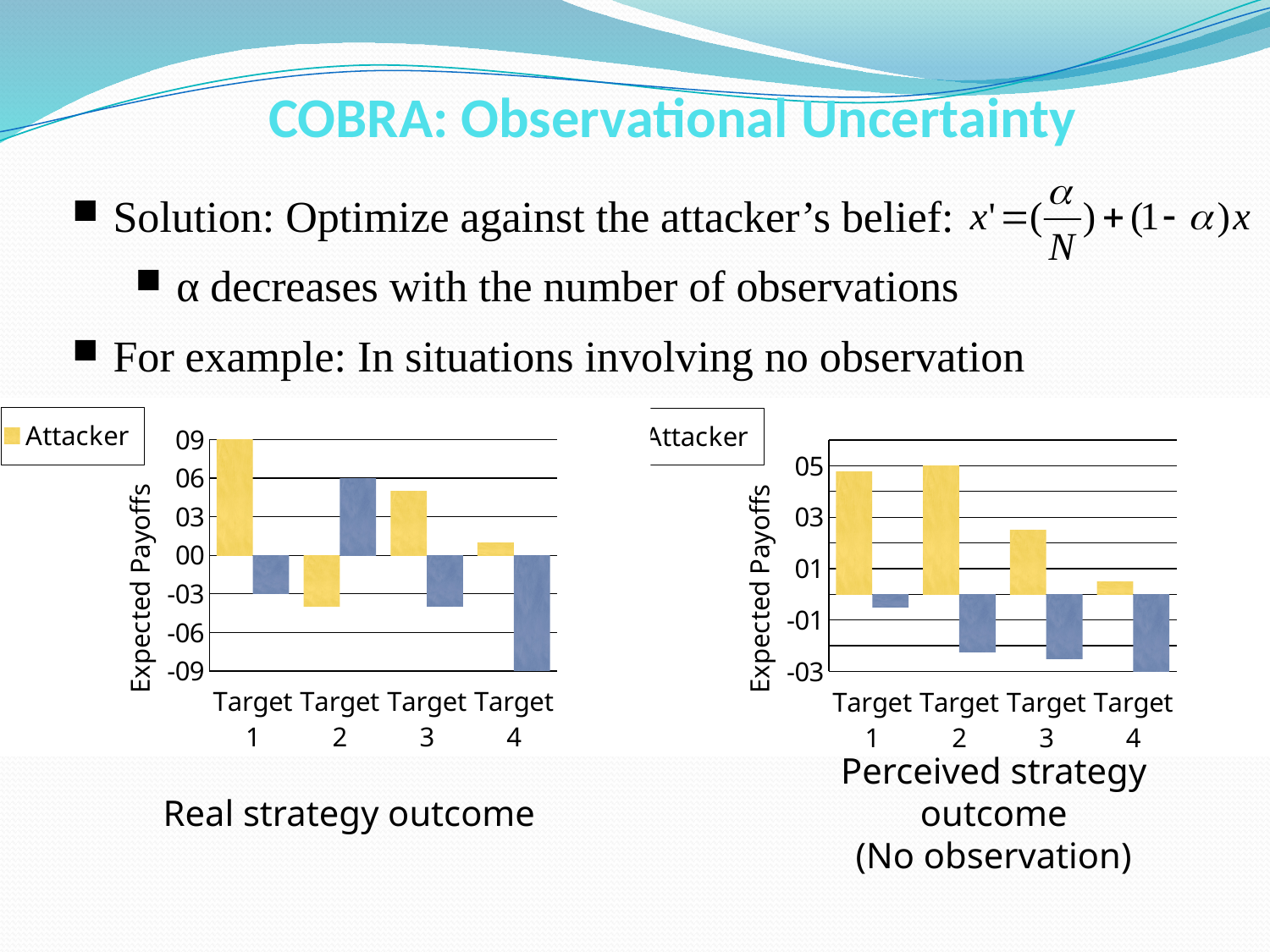
In the 'Real strategy outcome' chart, what is the Attacker expected payoff for Target 1? 09 In the 'Real strategy outcome' chart, which target has the highest Attacker expected payoff? Target 1 In the 'Real strategy outcome' chart, is the Attacker value for Target 3 greater or less than 03? greater In the 'Perceived strategy outcome (No observation)' chart, which has the larger Attacker expected payoff, Target 3 or Target 4? Target 3 In the 'Real strategy outcome' chart, which target has the lowest Attacker expected payoff? Target 2 What kind of chart is the 'Real strategy outcome' chart? bar chart In the 'Real strategy outcome' chart, is the Attacker value for Target 2 greater or less than 00? less In the 'Real strategy outcome' chart, which has the larger Attacker expected payoff, Target 1 or Target 3? Target 1 In the 'Perceived strategy outcome (No observation)' chart, is the Attacker value for Target 3 greater or less than 01? greater How many targets are shown on the x axis of the 'Perceived strategy outcome (No observation)' chart? 4 In the 'Perceived strategy outcome (No observation)' chart, which target has the lowest Attacker expected payoff? Target 4 What is the y-axis label of the 'Real strategy outcome' chart? Expected Payoffs